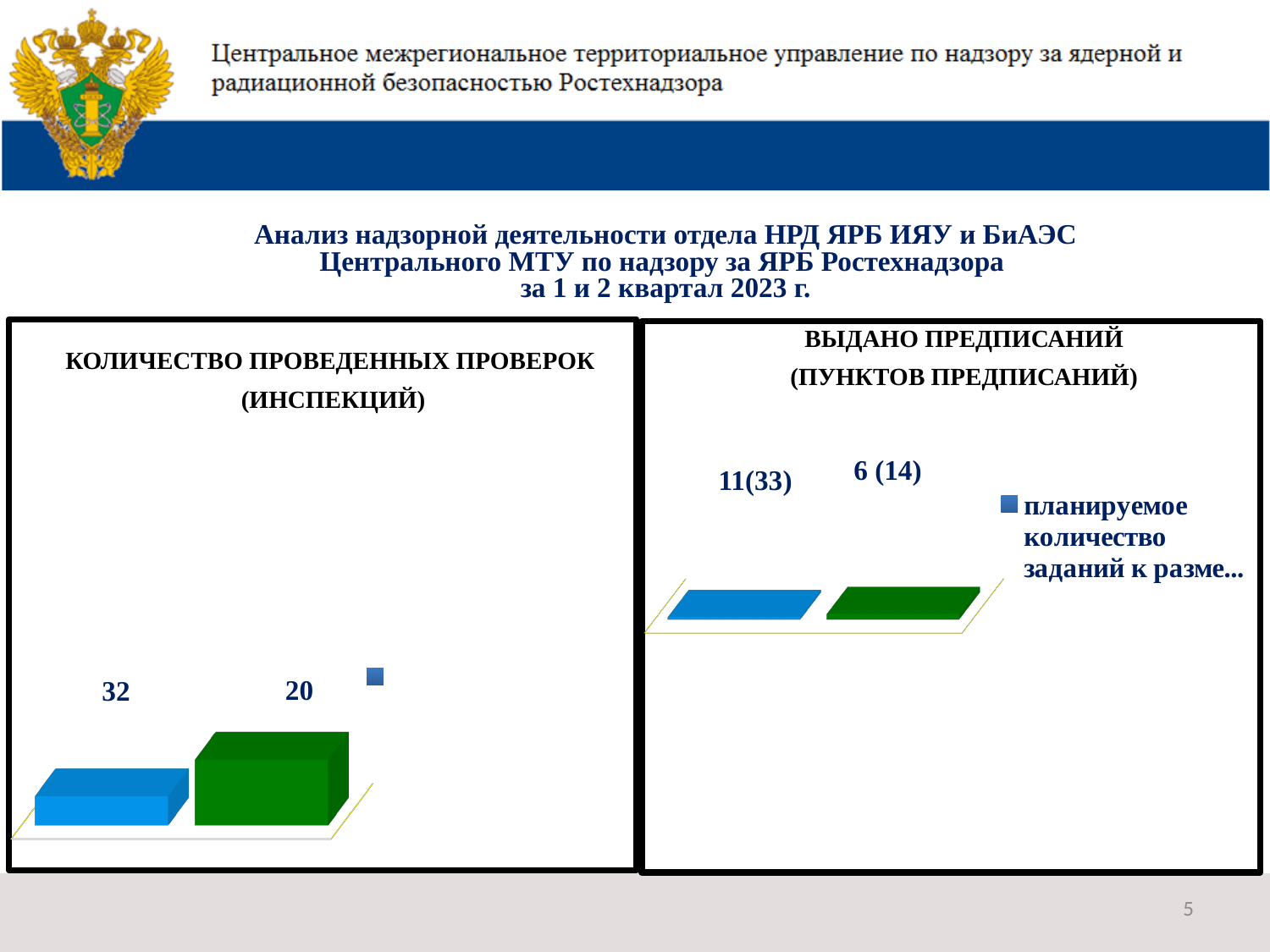
What kind of chart is the right chart, 'ВЫДАНО ПРЕДПИСАНИЙ (ПУНКТОВ ПРЕДПИСАНИЙ)'? bar chart In the right chart 'ВЫДАНО ПРЕДПИСАНИЙ (ПУНКТОВ ПРЕДПИСАНИЙ)', what label is shown above the green bar? 6 (14) In the right chart 'ВЫДАНО ПРЕДПИСАНИЙ (ПУНКТОВ ПРЕДПИСАНИЙ)', what label is shown above the blue bar? 11(33) What is the title of the chart on the right side of the slide? ВЫДАНО ПРЕДПИСАНИЙ (ПУНКТОВ ПРЕДПИСАНИЙ) How many bars are plotted in the left chart 'КОЛИЧЕСТВО ПРОВЕДЕННЫХ ПРОВЕРОК (ИНСПЕКЦИЙ)'? 2 In the left chart 'КОЛИЧЕСТВО ПРОВЕДЕННЫХ ПРОВЕРОК (ИНСПЕКЦИЙ)', what is the difference between the labelled values of the blue bar and the green bar? 12 In the left chart 'КОЛИЧЕСТВО ПРОВЕДЕННЫХ ПРОВЕРОК (ИНСПЕКЦИЙ)', which bar has the larger labelled value, the blue one or the green one? the blue one In the left chart 'КОЛИЧЕСТВО ПРОВЕДЕННЫХ ПРОВЕРОК (ИНСПЕКЦИЙ)', what value is labelled on the green bar? 20 What kind of chart is the left chart, 'КОЛИЧЕСТВО ПРОВЕДЕННЫХ ПРОВЕРОК (ИНСПЕКЦИЙ)'? bar chart How many bars are plotted in the right chart 'ВЫДАНО ПРЕДПИСАНИЙ (ПУНКТОВ ПРЕДПИСАНИЙ)'? 2 What is the title of the chart on the left side of the slide? КОЛИЧЕСТВО ПРОВЕДЕННЫХ ПРОВЕРОК (ИНСПЕКЦИЙ) In the left chart 'КОЛИЧЕСТВО ПРОВЕДЕННЫХ ПРОВЕРОК (ИНСПЕКЦИЙ)', what value is labelled on the blue bar? 32